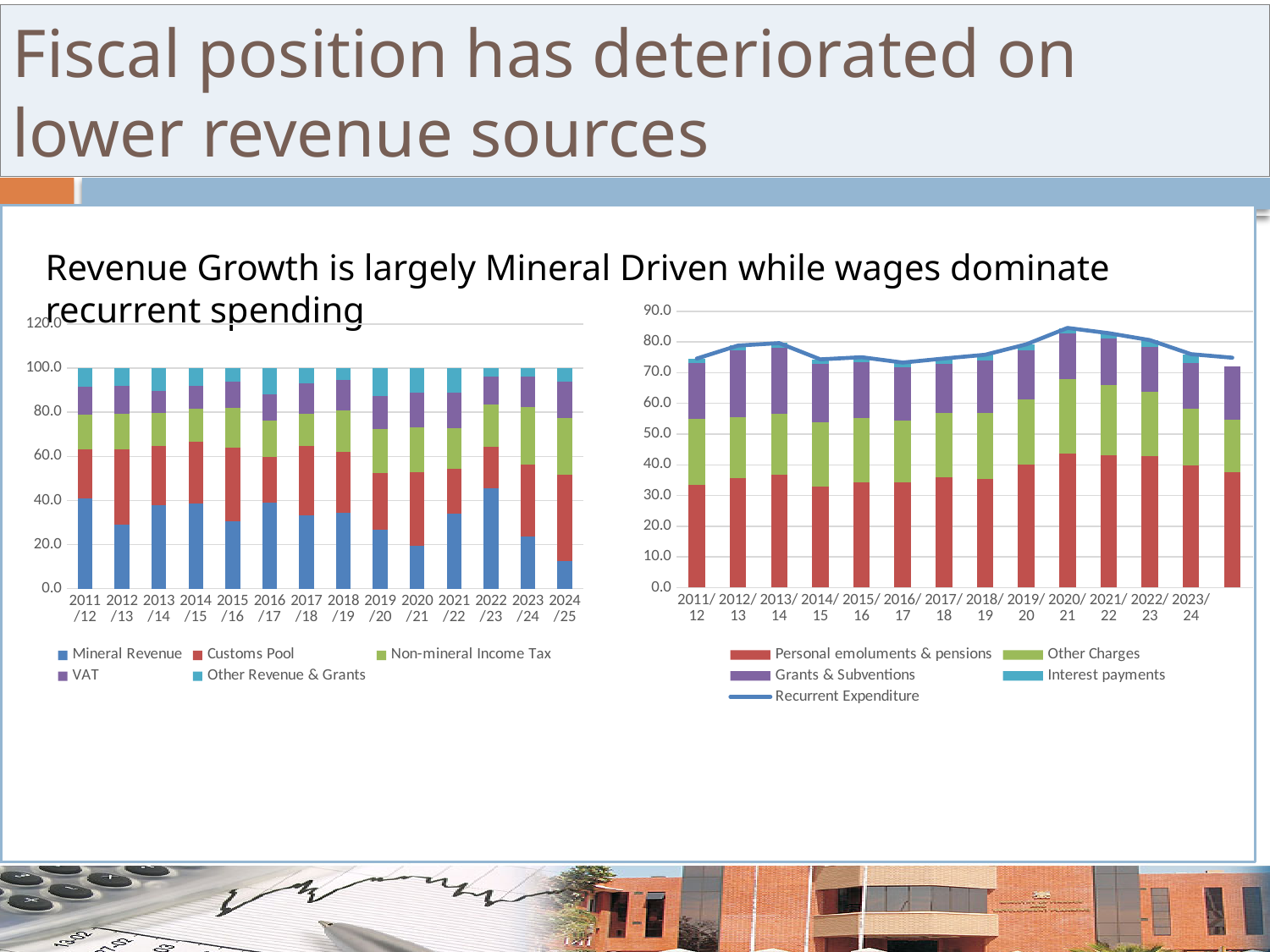
In the right chart, which year has the highest Recurrent Expenditure? 2020/21 In the left chart, is the Mineral Revenue value for 2024/25 greater or less than 20.0? less In the right chart, is the Personal emoluments & pensions value for 2011/12 greater or less than 40.0? less How many entries does the legend of the right chart list? 5 In the left chart, which year has the lowest Mineral Revenue value? 2024/25 In the right chart, is the Recurrent Expenditure for 2020/21 greater or less than 80.0? greater How many series does the legend of the left chart list? 5 How many fiscal years are shown on the x axis of the left chart (Mineral Revenue, Customs Pool, etc.)? 14 How many fiscal years are shown on the x axis of the right chart (Personal emoluments & pensions, Other Charges, etc.)? 13 In the right chart, which series is plotted as a line rather than as stacked bars? Recurrent Expenditure What kind of chart is the left chart showing Mineral Revenue, Customs Pool and other revenue sources? Stacked bar chart